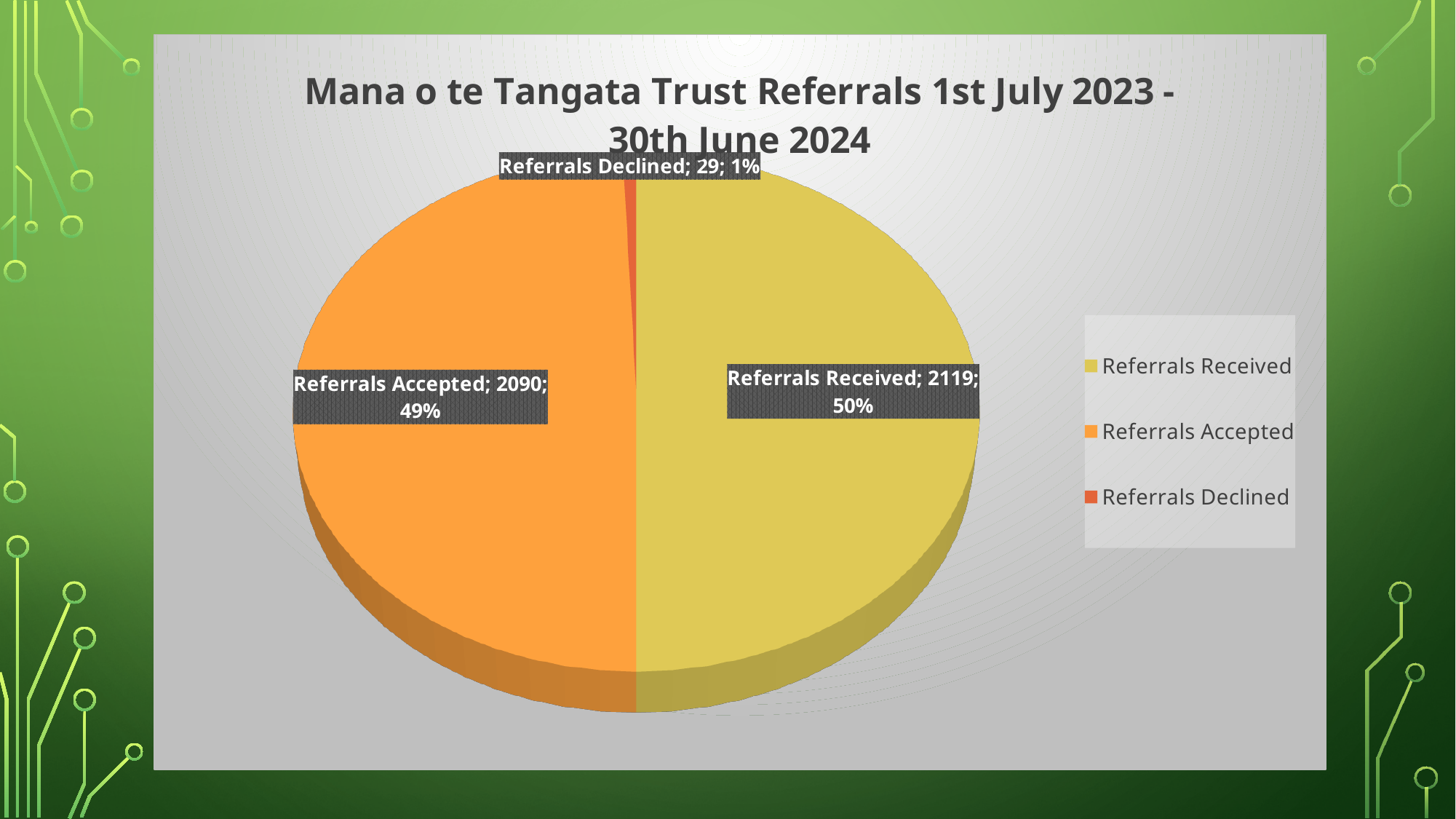
What is the value for Referrals Accepted? 2090 What is the value for Referrals Declined? 29 Which category has the smallest slice? Referrals Declined Which is larger, Referrals Accepted or Referrals Declined? Referrals Accepted What is the difference between Referrals Received and Referrals Accepted? 29 Which category has the largest slice? Referrals Received How many categories does the pie chart have? 3 What share of the pie does Referrals Accepted represent? 49% What kind of chart is shown on the slide? Pie chart What is the title of the chart? Mana o te Tangata Trust Referrals 1st July 2023 - 30th June 2024 What share of the pie does Referrals Declined represent? 1% What is the value for Referrals Received? 2119